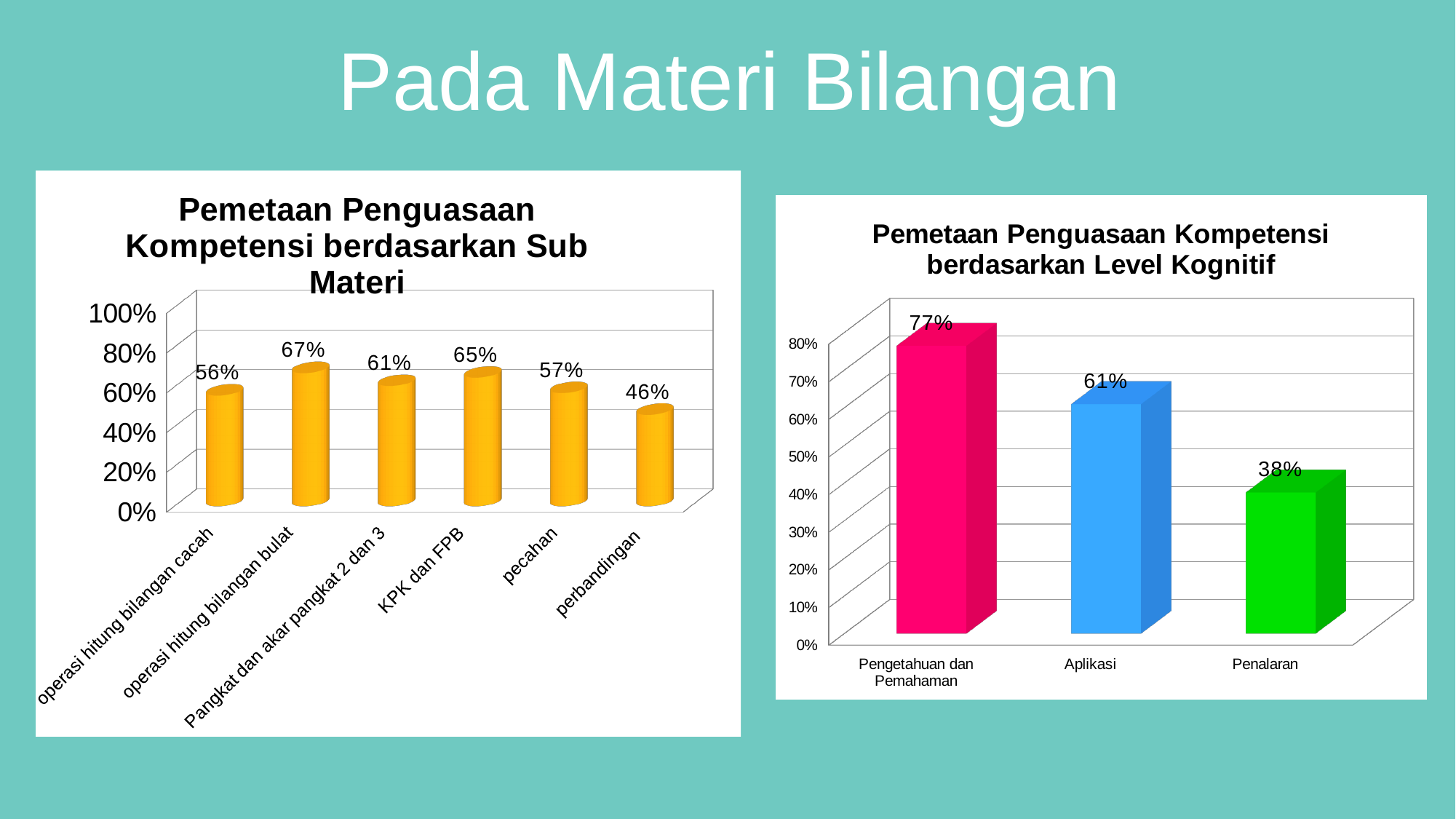
In the right chart (Pemetaan Penguasaan Kompetensi berdasarkan Level Kognitif), what is the difference between Pengetahuan dan Pemahaman and Penalaran? 39% In the left chart (Pemetaan Penguasaan Kompetensi berdasarkan Sub Materi), which sub materi has the lowest value? perbandingan In the left chart (Pemetaan Penguasaan Kompetensi berdasarkan Sub Materi), what is the value for perbandingan? 46% In the left chart (Pemetaan Penguasaan Kompetensi berdasarkan Sub Materi), how many sub materi categories are shown? 6 In the right chart (Pemetaan Penguasaan Kompetensi berdasarkan Level Kognitif), which level has the highest value? Pengetahuan dan Pemahaman In the right chart (Pemetaan Penguasaan Kompetensi berdasarkan Level Kognitif), what is the value for Aplikasi? 61% What kind of chart is the right chart (Pemetaan Penguasaan Kompetensi berdasarkan Level Kognitif)? bar chart In the left chart (Pemetaan Penguasaan Kompetensi berdasarkan Sub Materi), which is larger: pecahan or Pangkat dan akar pangkat 2 dan 3? Pangkat dan akar pangkat 2 dan 3 In the right chart (Pemetaan Penguasaan Kompetensi berdasarkan Level Kognitif), do the values rise or fall from left to right? fall In the left chart (Pemetaan Penguasaan Kompetensi berdasarkan Sub Materi), what is the value for KPK dan FPB? 65% In the left chart (Pemetaan Penguasaan Kompetensi berdasarkan Sub Materi), what is the difference between operasi hitung bilangan bulat and operasi hitung bilangan cacah? 11% In the left chart (Pemetaan Penguasaan Kompetensi berdasarkan Sub Materi), which sub materi has the highest value? operasi hitung bilangan bulat